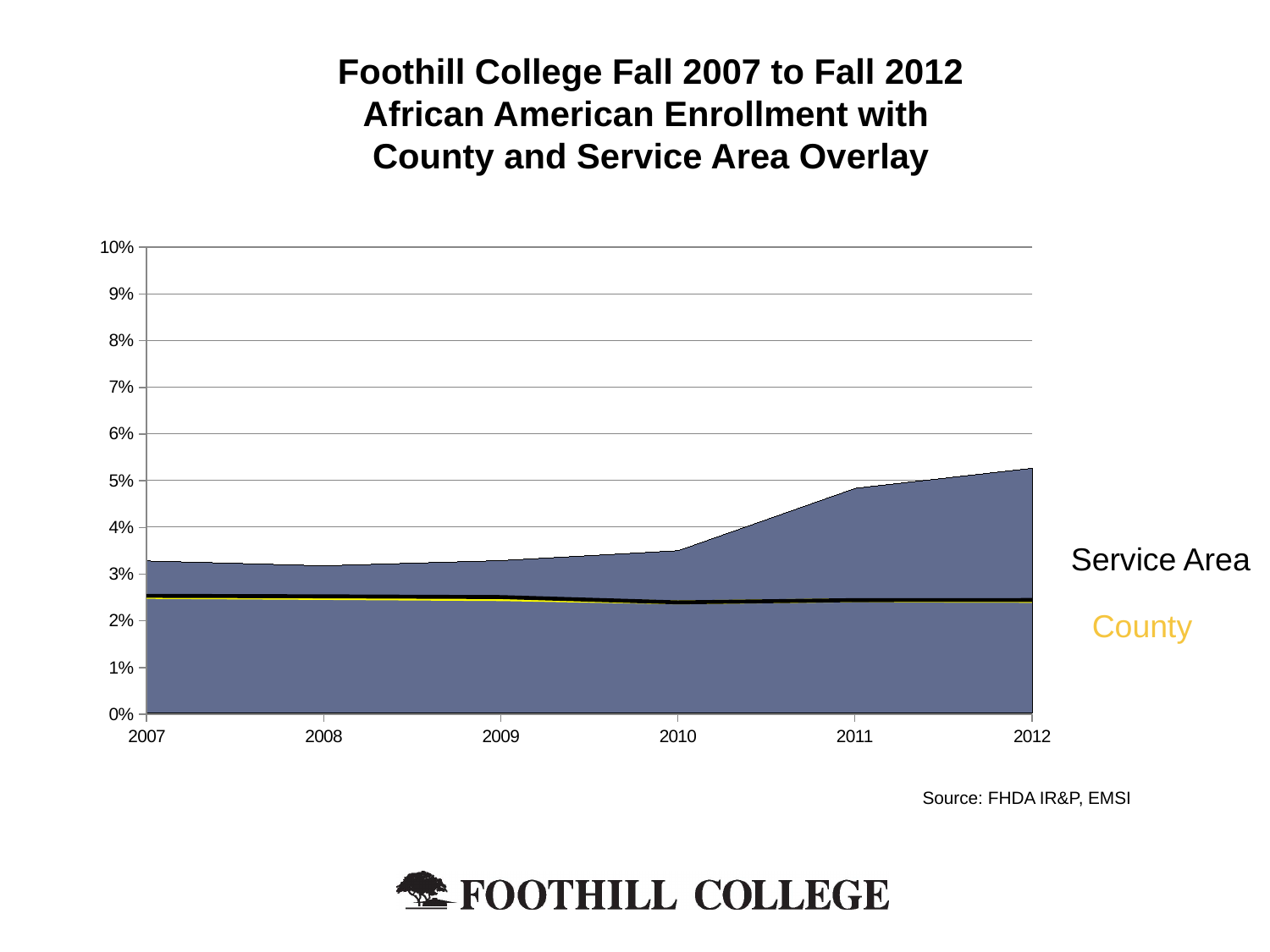
Is the value of the shaded enrollment area in 2012 greater or less than 5%? greater Is the Service Area line in 2012 greater or less than 3%? less Is the value of the shaded enrollment area in 2010 greater or less than 4%? less Which year has the highest value for the shaded enrollment area? 2012 Which is larger, the shaded enrollment area value in 2012 or in 2007? 2012 What is the source cited below the chart? FHDA IR&P, EMSI Do the values of the shaded enrollment area rise or fall from 2007 to 2012? rise How many years are shown along the x axis of the chart? 6 What are the two overlay lines on the chart labelled? Service Area and County What kind of chart is shown on the slide? area chart